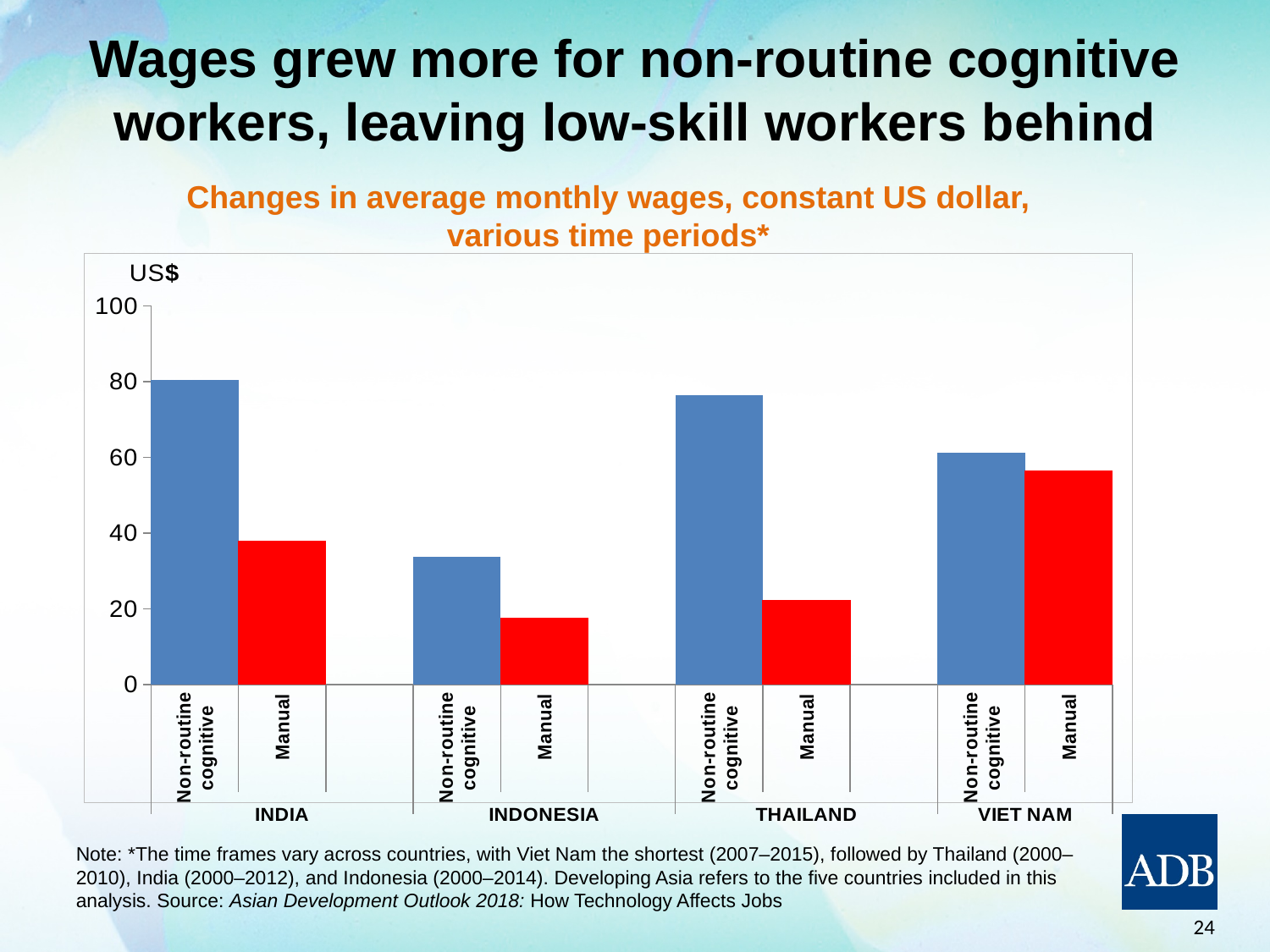
What is the title of the chart? Changes in average monthly wages, constant US dollar, various time periods* Is the value for Non-routine cognitive in Thailand greater or less than 60? greater What kind of chart is shown on the slide? bar chart How many countries are shown on the x axis of the chart? 4 Which is larger, the Manual value for India or the Manual value for Thailand? India Which bar in the chart is the lowest? Manual, Indonesia Is the value for Non-routine cognitive in Indonesia greater or less than 40? less Is the value for Non-routine cognitive in India greater or less than 60? greater Which country has the highest value for Non-routine cognitive? India What unit is shown on the y axis of the chart? US$ How many bars are plotted in the chart? 8